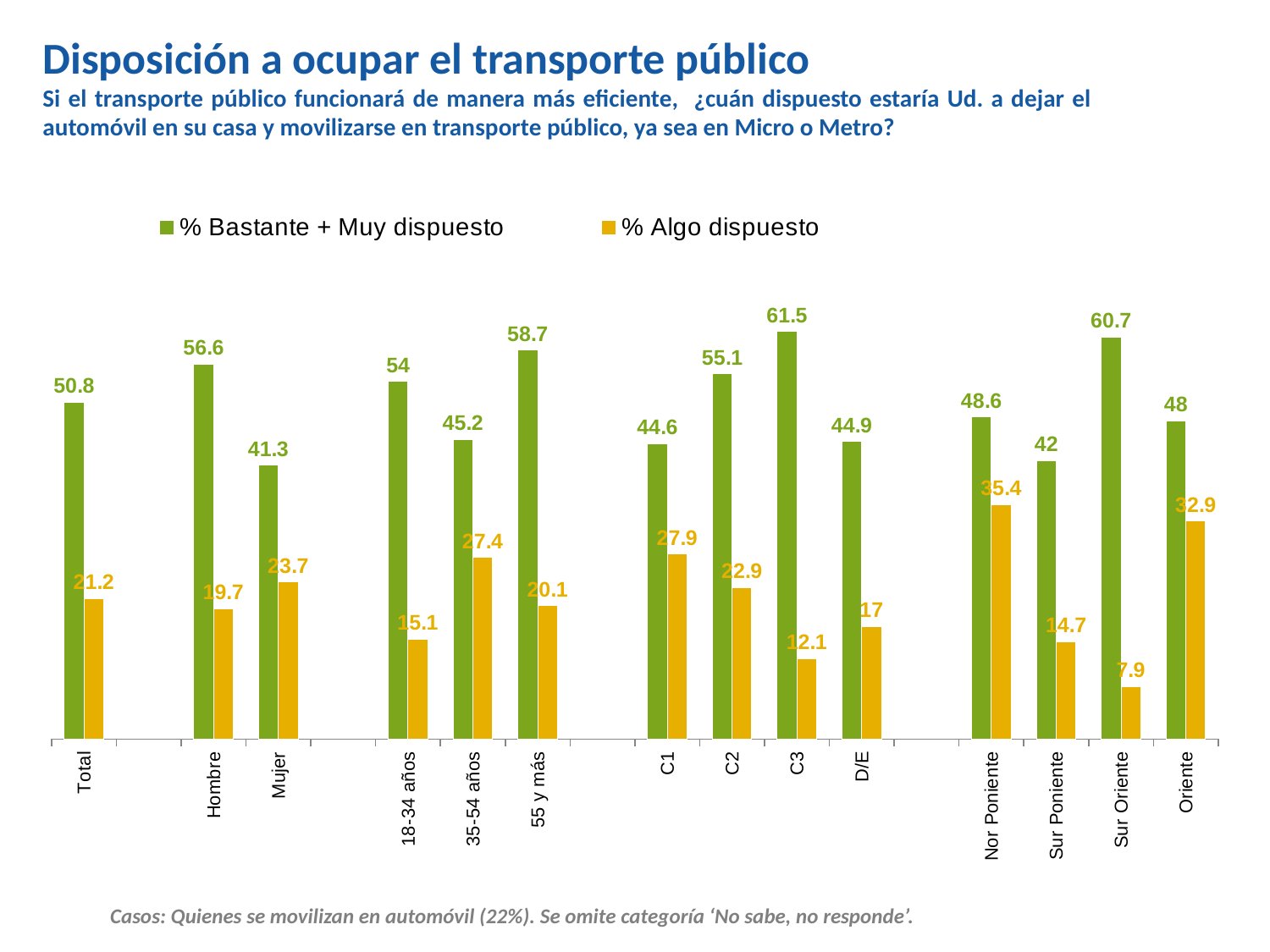
How many series does the legend list? 2 How many categories are shown on the x axis? 14 What is the difference between the "% Bastante + Muy dispuesto" values for Hombre and Mujer? 15.3 What is the total of the two series values for Oriente? 80.9 Which category has the highest value for "% Bastante + Muy dispuesto"? C3 Which category has the lowest value for "% Algo dispuesto"? Sur Oriente Which is larger, the "% Algo dispuesto" value for C1 or for C2? C1 What is the value of "% Bastante + Muy dispuesto" for 55 y más? 58.7 Which category has the lowest value for "% Bastante + Muy dispuesto"? Mujer What is the value of "% Algo dispuesto" for Nor Poniente? 35.4 What is the value of "% Bastante + Muy dispuesto" for Total? 50.8 What kind of chart is shown on the slide? Bar chart